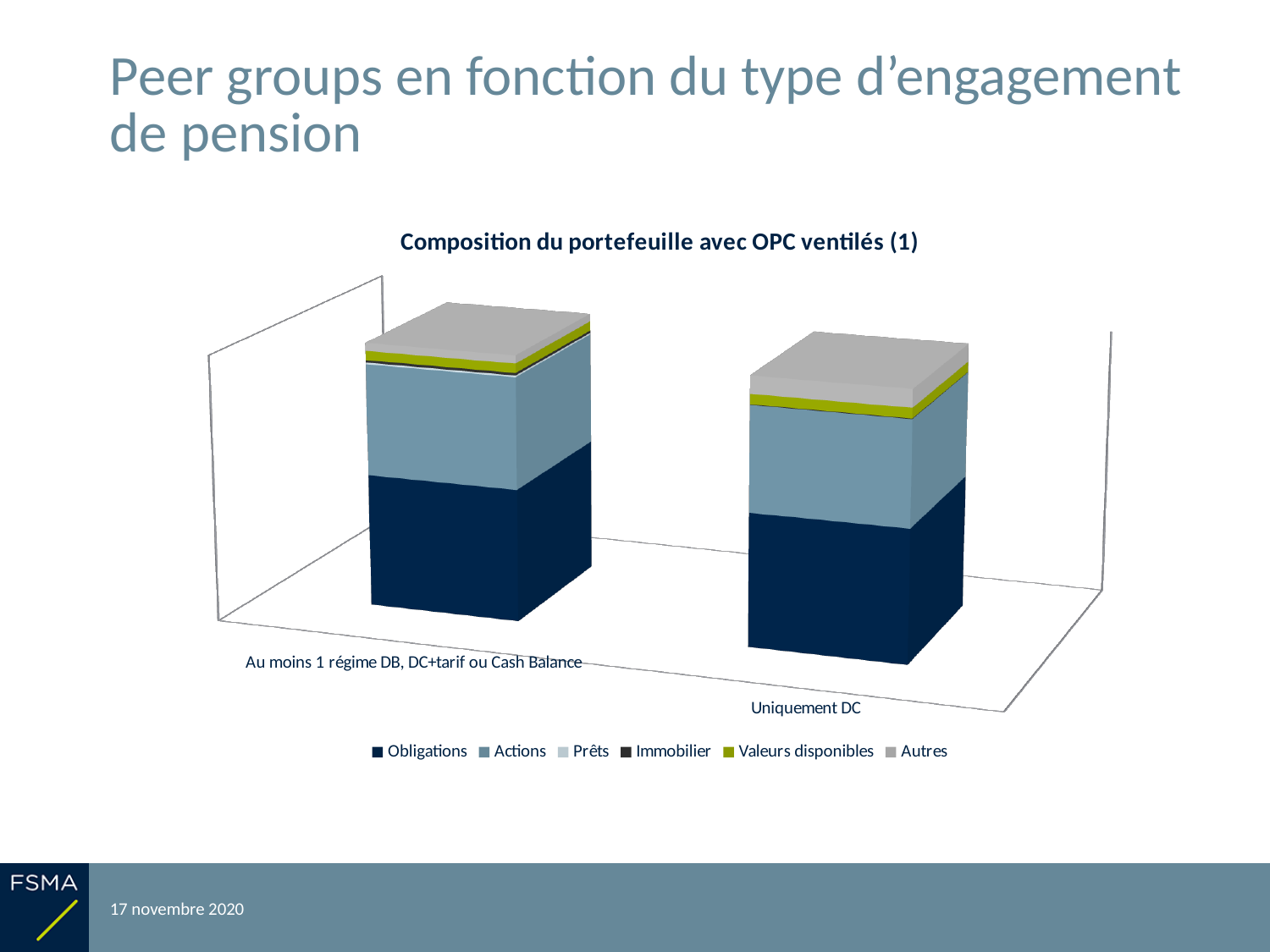
What are the two category labels shown on the x axis of the chart? Au moins 1 régime DB, DC+tarif ou Cash Balance; Uniquement DC In the bar for "Au moins 1 régime DB, DC+tarif ou Cash Balance", which segment is larger: Obligations or Actions? Obligations What kind of chart is shown under the title "Composition du portefeuille avec OPC ventilés (1)"? Stacked bar chart Which series is listed first in the chart legend? Obligations In the bar for "Uniquement DC", which segment is larger: Obligations or Actions? Obligations In the bar for "Uniquement DC", which segment is larger: Actions or Valeurs disponibles? Actions How many series does the legend of the chart list? 6 How many categories (bars) are plotted in the chart? 2 What is the title of the chart on the slide? Composition du portefeuille avec OPC ventilés (1)